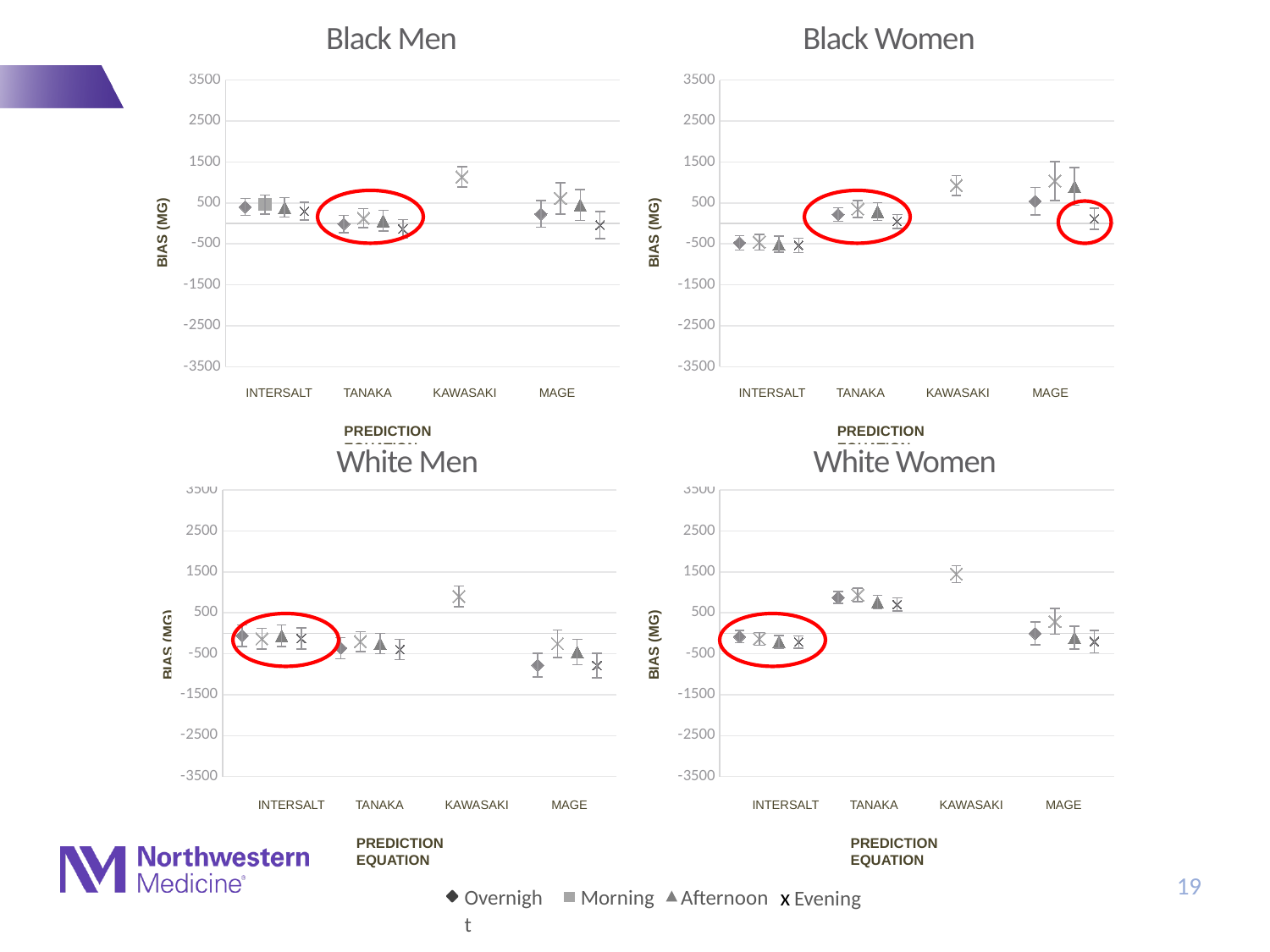
On the White Women chart, is the bias for KAWASAKI greater or less than 500? greater How many series does the legend at the bottom of the slide list? 4 How many prediction equations are shown on the x axis of the Black Men chart? 4 On the Black Women chart, which prediction equation has the lowest bias? INTERSALT On the White Women chart, which has the larger bias, TANAKA or MAGE? TANAKA On the White Women chart, which prediction equation has the highest bias? KAWASAKI What kind of chart is the White Women chart? Scatter chart What is the y-axis label on the Black Men chart? BIAS (MG) On the White Men chart, which prediction equation has the lowest bias? MAGE On the Black Men chart, which prediction equation has the highest bias? KAWASAKI On the Black Men chart, is the bias for KAWASAKI greater or less than 500? greater On the Black Women chart, is the bias for INTERSALT greater or less than 0? less